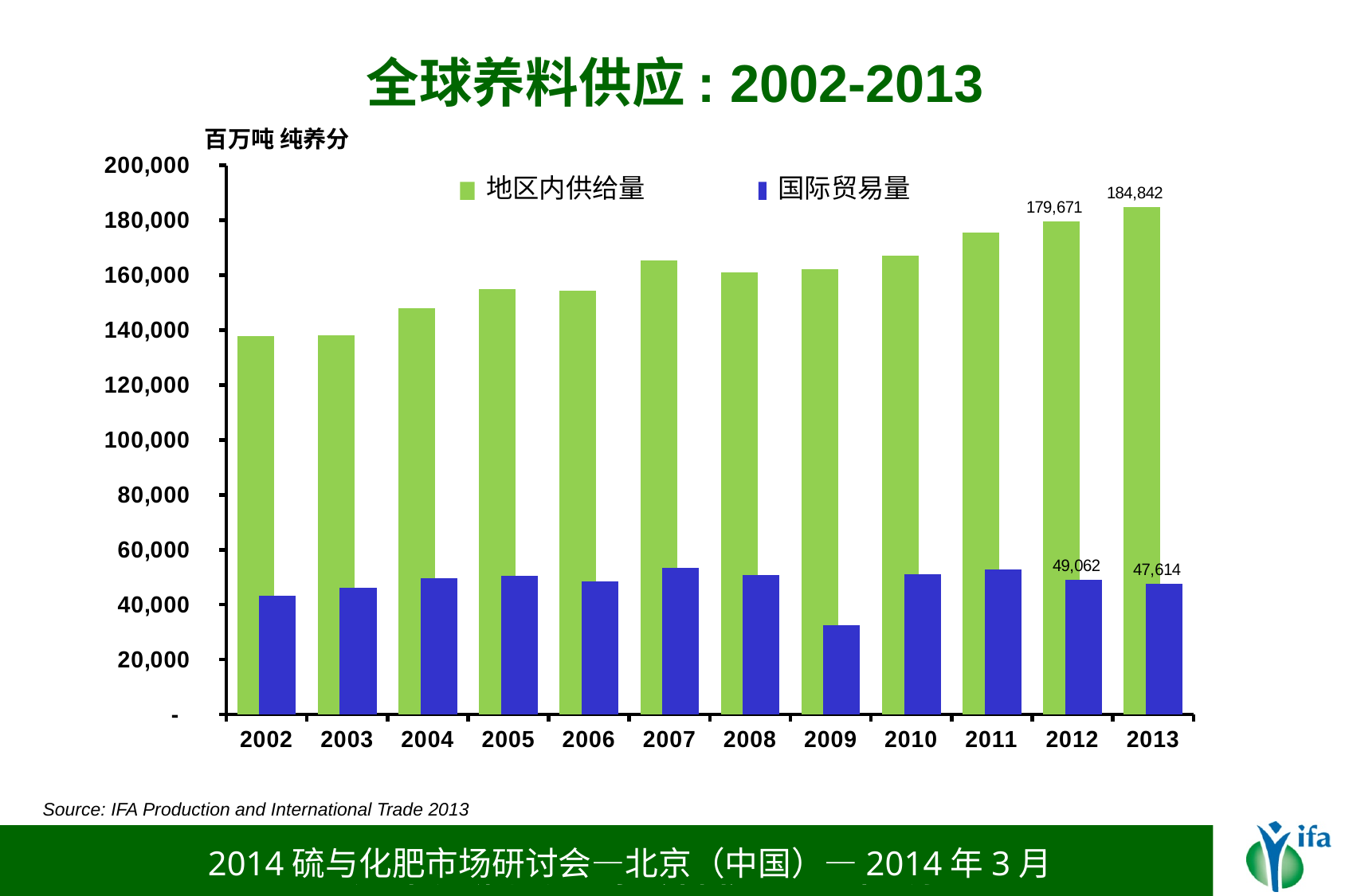
By how much did 地区内供给量 increase from 2012 to 2013? 5,171 What is the value of 国际贸易量 for 2013? 47,614 Which year has the highest 地区内供给量? 2013 How many years are shown on the x axis? 12 How many series does the legend list? 2 What is the value of 国际贸易量 for 2012? 49,062 What is the value of 地区内供给量 for 2013? 184,842 What is the difference between 国际贸易量 in 2012 and 2013? 1,448 What is the value of 地区内供给量 for 2012? 179,671 Which year has the lowest 国际贸易量? 2009 Is the value of 国际贸易量 for 2009 greater or less than 40,000? less Does 地区内供给量 generally rise or fall from 2002 to 2013? rise